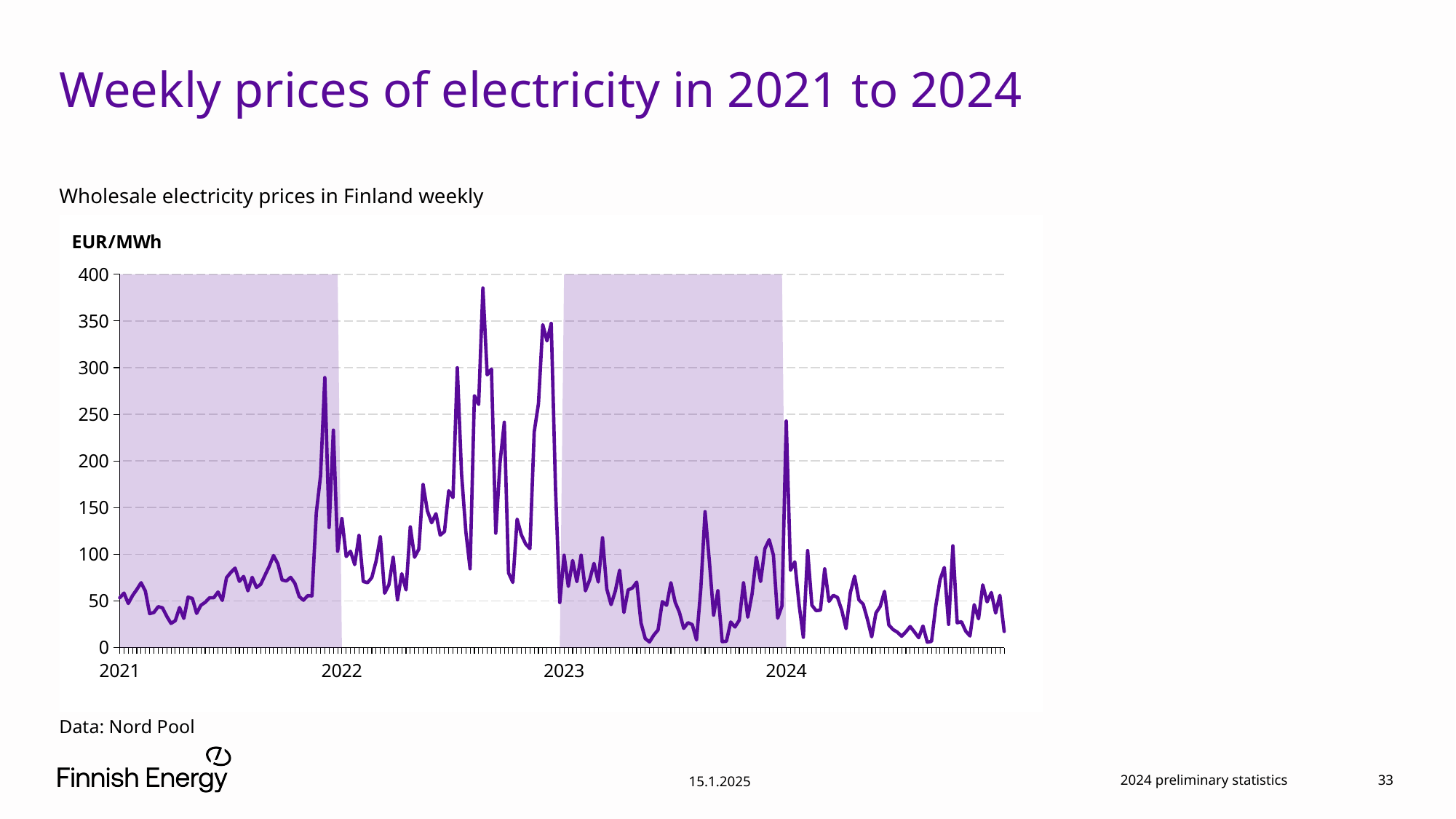
Is the highest weekly price in 2022 greater or less than 350? greater Is the lowest weekly price in 2023 greater or less than 50? less Is the weekly price at the start of 2021 greater or less than 100? less How many years are labelled on the x axis of the chart? 4 What unit is shown on the y axis of the chart? EUR/MWh What is the data source given below the chart? Nord Pool In which year does the weekly electricity price reach its highest peak? 2022 What kind of chart is shown on the slide? line chart From the peak in 2022 to the end of 2024, do weekly prices generally rise or fall? fall